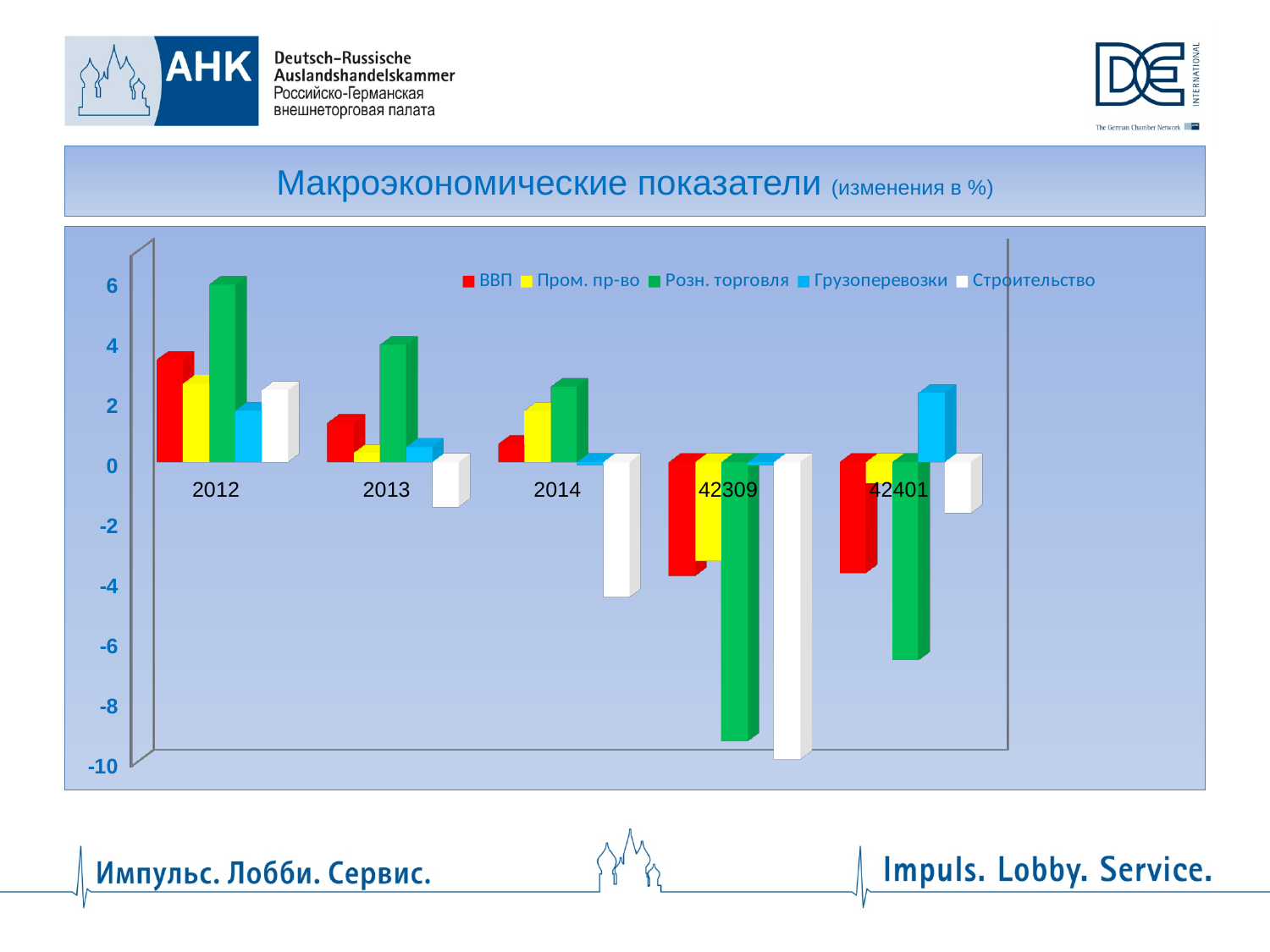
Is the value for Строительство in 2014 greater or less than -2? less Is the value for Розн. торговля in 2012 greater or less than 4? greater Which category has the highest value for Розн. торговля? 2012 What kind of chart is shown on the slide? bar chart How many series does the legend list? 5 Which category has the lowest value for Строительство? 42309 What is the title of the chart? Макроэкономические показатели (изменения в %) How many categories are shown along the x axis? 5 Is the value for Розн. торговля in 42309 greater or less than -8? less What colour represents Грузоперевозки in the legend? blue Which is larger, the ВВП value for 2012 or for 2013? 2012 Does the ВВП value rise or fall from 2012 to 2014? fall